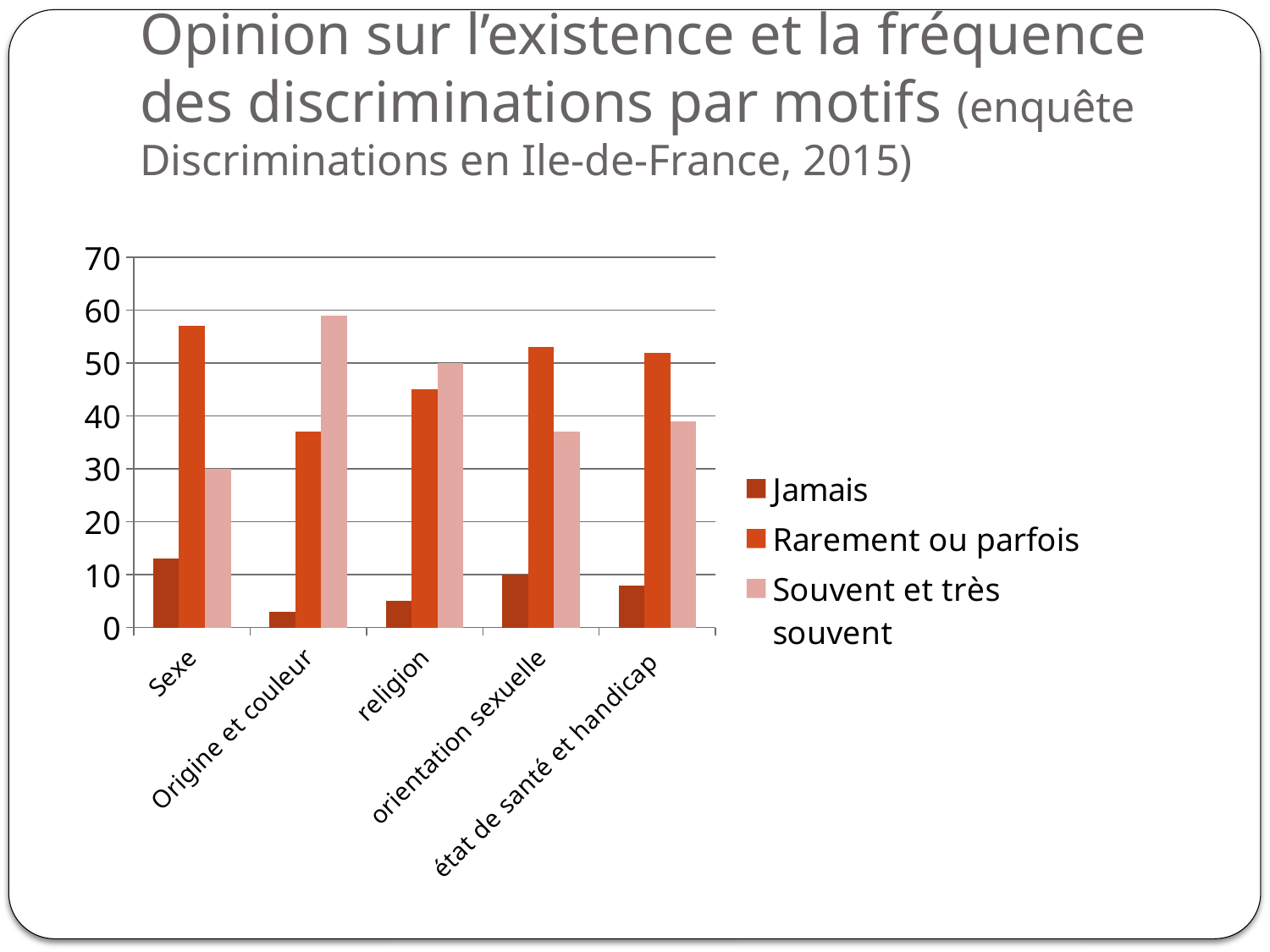
Which category has the highest value for the 'Rarement ou parfois' series? Sexe Which category has the lowest value for the 'Jamais' series? Origine et couleur Is the value for 'Rarement ou parfois' in the Sexe category greater or less than 50? greater How many series does the legend list? 3 Which category has the highest value for the 'Souvent et très souvent' series? Origine et couleur Is the value for 'Jamais' in the Origine et couleur category greater or less than 10? less For the orientation sexuelle category, which is larger: 'Rarement ou parfois' or 'Souvent et très souvent'? Rarement ou parfois What kind of chart is shown on the slide? bar chart For the religion category, which is larger: 'Rarement ou parfois' or 'Souvent et très souvent'? Souvent et très souvent Which series is shown in the darkest colour in the legend? Jamais How many categories are shown on the x axis? 5